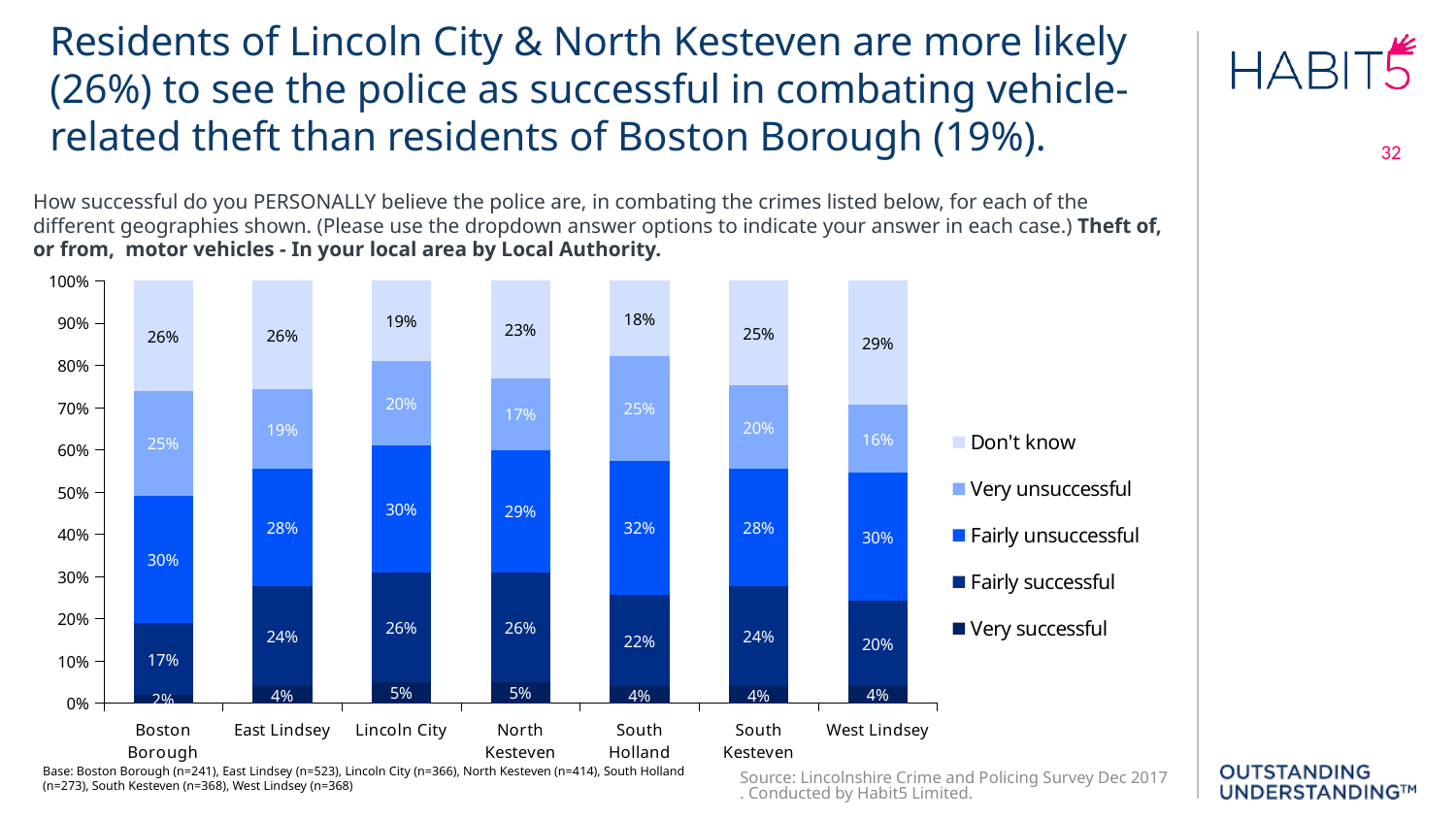
How many local authorities are shown on the x axis? 7 What is the 'Very unsuccessful' value for North Kesteven? 17% What percentage of Boston Borough residents said the police are 'Fairly successful'? 17% Which local authority has the lowest 'Very successful' value? Boston Borough Which local authority has the highest 'Fairly unsuccessful' value? South Holland How many percentage points higher is the 'Fairly successful' value for Lincoln City than for Boston Borough? 9 percentage points Which series is shown as the lightest-coloured segment at the top of each bar? Don't know Which has the larger 'Don't know' value, Lincoln City or South Holland? Lincoln City What is the 'Don't know' value for West Lindsey? 29% How many series does the legend list? 5 What kind of chart is shown on the slide? Stacked bar chart What is the combined 'Very successful' and 'Fairly successful' percentage for Lincoln City? 31%